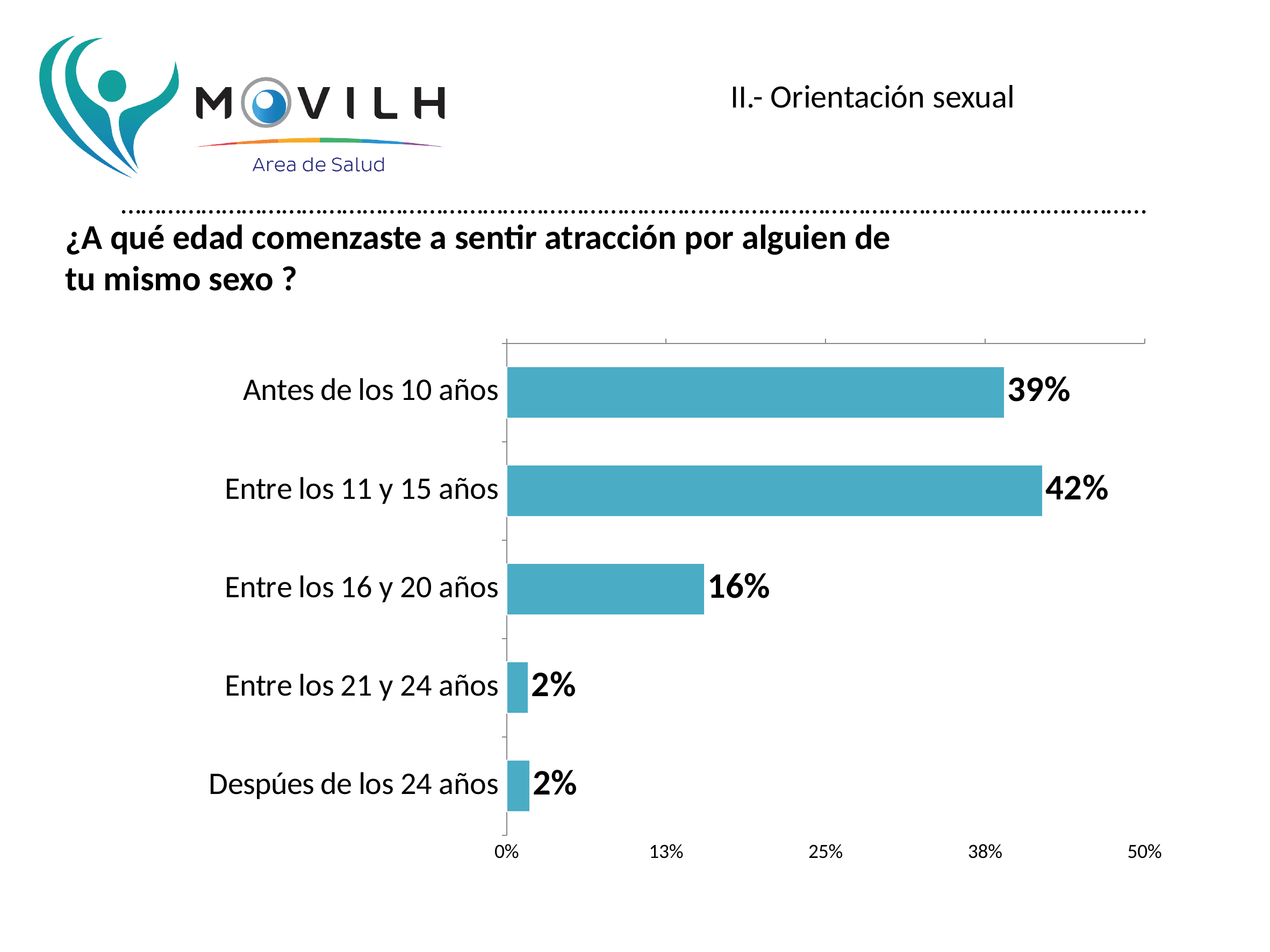
Which category has the highest value? Entre los 11 y 15 años How many categories are shown in the chart? 5 Is the value for "Entre los 16 y 20 años" greater or less than 25%? less What is the difference between the values for "Entre los 11 y 15 años" and "Antes de los 10 años"? 3% What is the value for "Entre los 11 y 15 años"? 42% What is the highest value shown on the horizontal axis? 50% What is the value for "Entre los 21 y 24 años"? 2% What is the difference between the values for "Antes de los 10 años" and "Entre los 16 y 20 años"? 23% Which is larger, the value for "Entre los 16 y 20 años" or the value for "Entre los 21 y 24 años"? Entre los 16 y 20 años What is the value for "Antes de los 10 años"? 39% What is the value for "Entre los 16 y 20 años"? 16% What kind of chart is shown on the slide? Bar chart